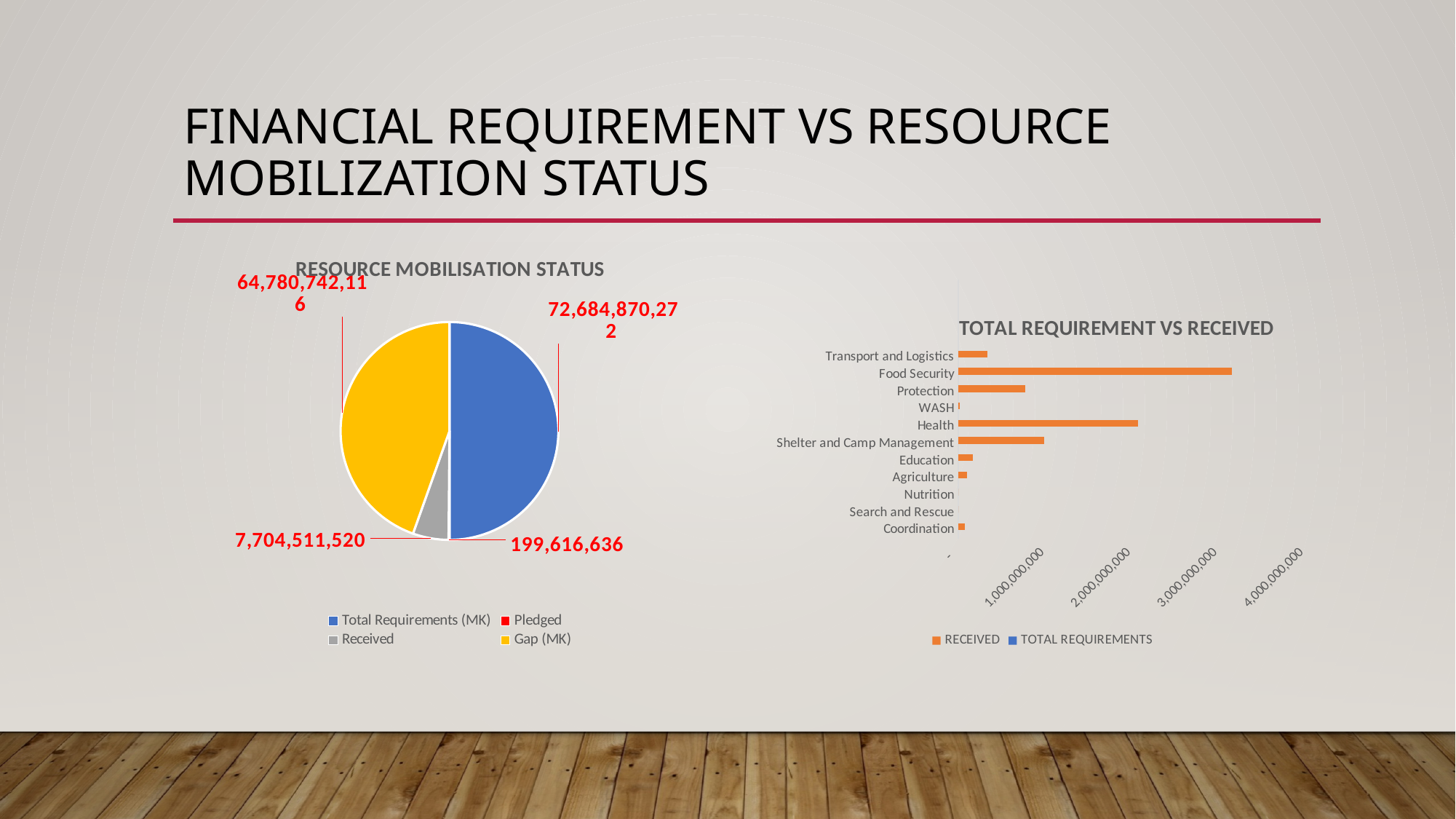
In the RESOURCE MOBILISATION STATUS chart, what is the difference between Total Requirements (MK) and Gap (MK)? 7,904,128,156 In the RESOURCE MOBILISATION STATUS chart, which legend entry has the smallest value? Pledged In the RESOURCE MOBILISATION STATUS pie chart, what is the value for Gap (MK)? 64,780,742,116 How many entries does the legend of the RESOURCE MOBILISATION STATUS chart list? 4 In the RESOURCE MOBILISATION STATUS pie chart, what is the value for Total Requirements (MK)? 72,684,870,272 In the TOTAL REQUIREMENT VS RECEIVED chart, which is larger, Health or Protection? Health In the TOTAL REQUIREMENT VS RECEIVED chart, is the value for Food Security greater or less than 3,000,000,000? greater What kind of chart is TOTAL REQUIREMENT VS RECEIVED? Bar chart How many categories are shown in the TOTAL REQUIREMENT VS RECEIVED chart? 11 In the RESOURCE MOBILISATION STATUS pie chart, what is the value for Pledged? 199,616,636 In the TOTAL REQUIREMENT VS RECEIVED chart, which category has the longest bar? Food Security In the RESOURCE MOBILISATION STATUS pie chart, what is the value for Received? 7,704,511,520